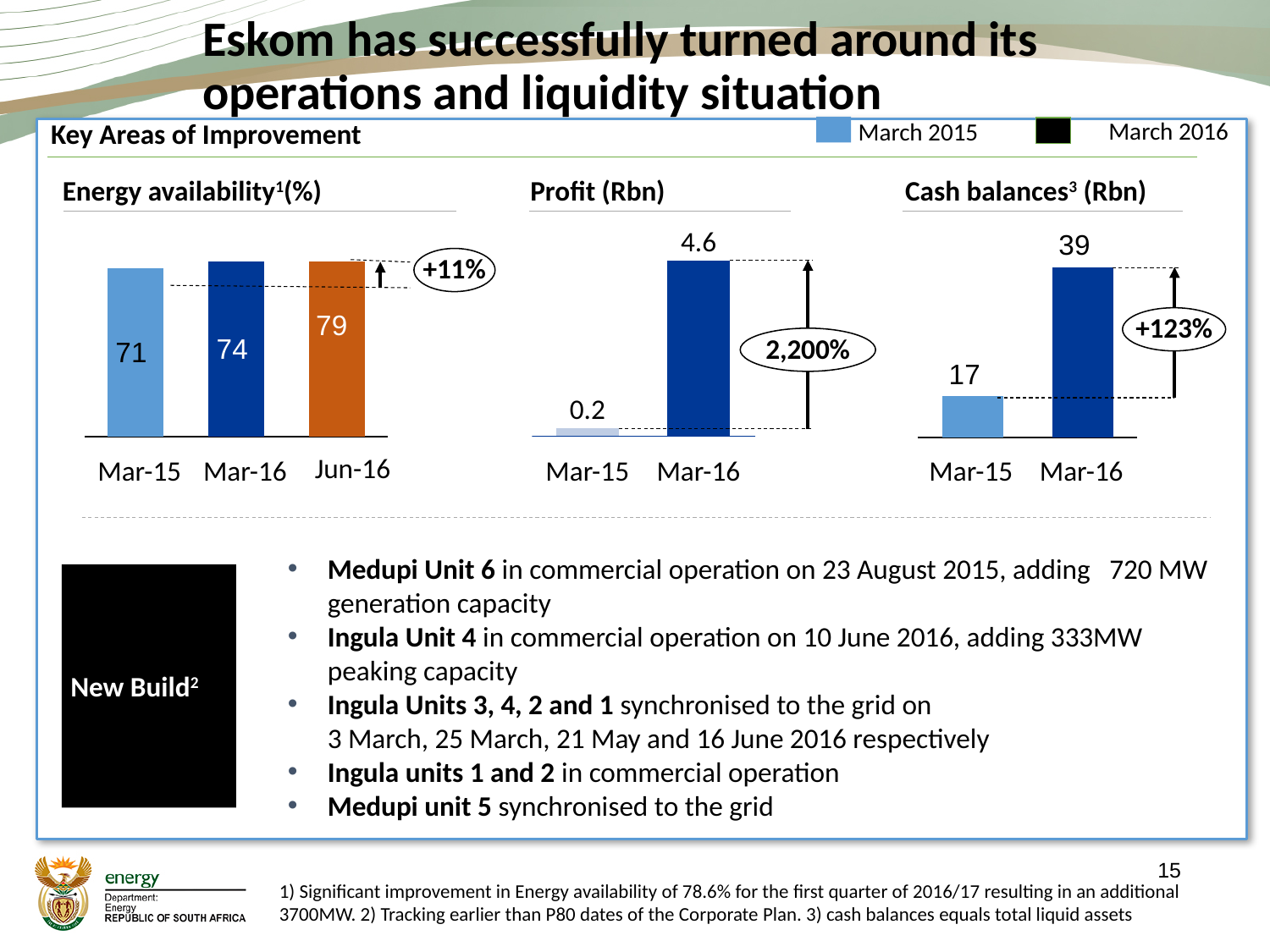
In the Energy availability chart, which period has the lowest value? Mar-15 In the Profit chart, what is the value for Mar-15? 0.2 In the Profit chart, what is the value for Mar-16? 4.6 In the Cash balances chart, what is the difference between the Mar-16 and Mar-15 values? 22 In the Cash balances chart, which period has the higher value, Mar-15 or Mar-16? Mar-16 In the Profit chart, what is the difference between the Mar-16 and Mar-15 values? 4.4 In the Energy availability chart, how many bars are plotted? 3 What type of chart is the Profit chart? Bar chart In the Cash balances chart, what is the value for Mar-16? 39 In the Energy availability chart, what is the value for Mar-16? 74 In the Energy availability chart, what is the difference between the Jun-16 and Mar-15 values? 8 In the Energy availability chart, what is the value for Jun-16? 79